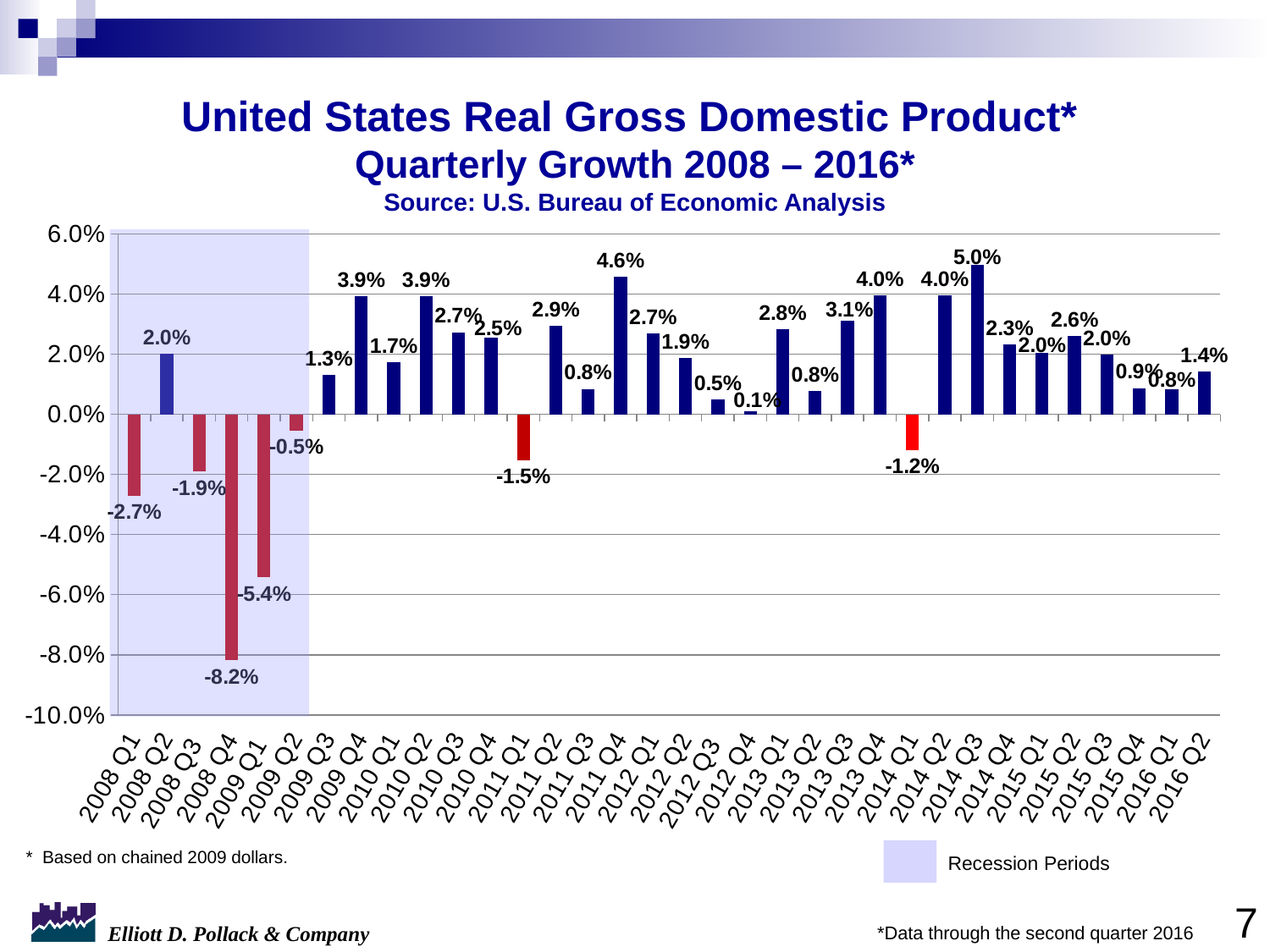
What is the quarterly growth value for 2014 Q3? 5.0% What is the quarterly growth value for 2011 Q1? -1.5% What is the quarterly growth value for 2008 Q4? -8.2% Which quarter has the lowest growth value? 2008 Q4 Is the value for 2009 Q1 greater or less than -4.0%? less What does the shaded area on the left of the chart represent, according to the legend? Recession Periods What is the quarterly growth value for 2016 Q2? 1.4% What kind of chart is shown on the slide? bar chart What is the difference between the growth values for 2011 Q4 and 2012 Q1? 1.9% How many quarters are plotted on the chart? 34 Which is larger, the growth value for 2013 Q3 or for 2013 Q4? 2013 Q4 Which quarter has the highest growth value? 2014 Q3